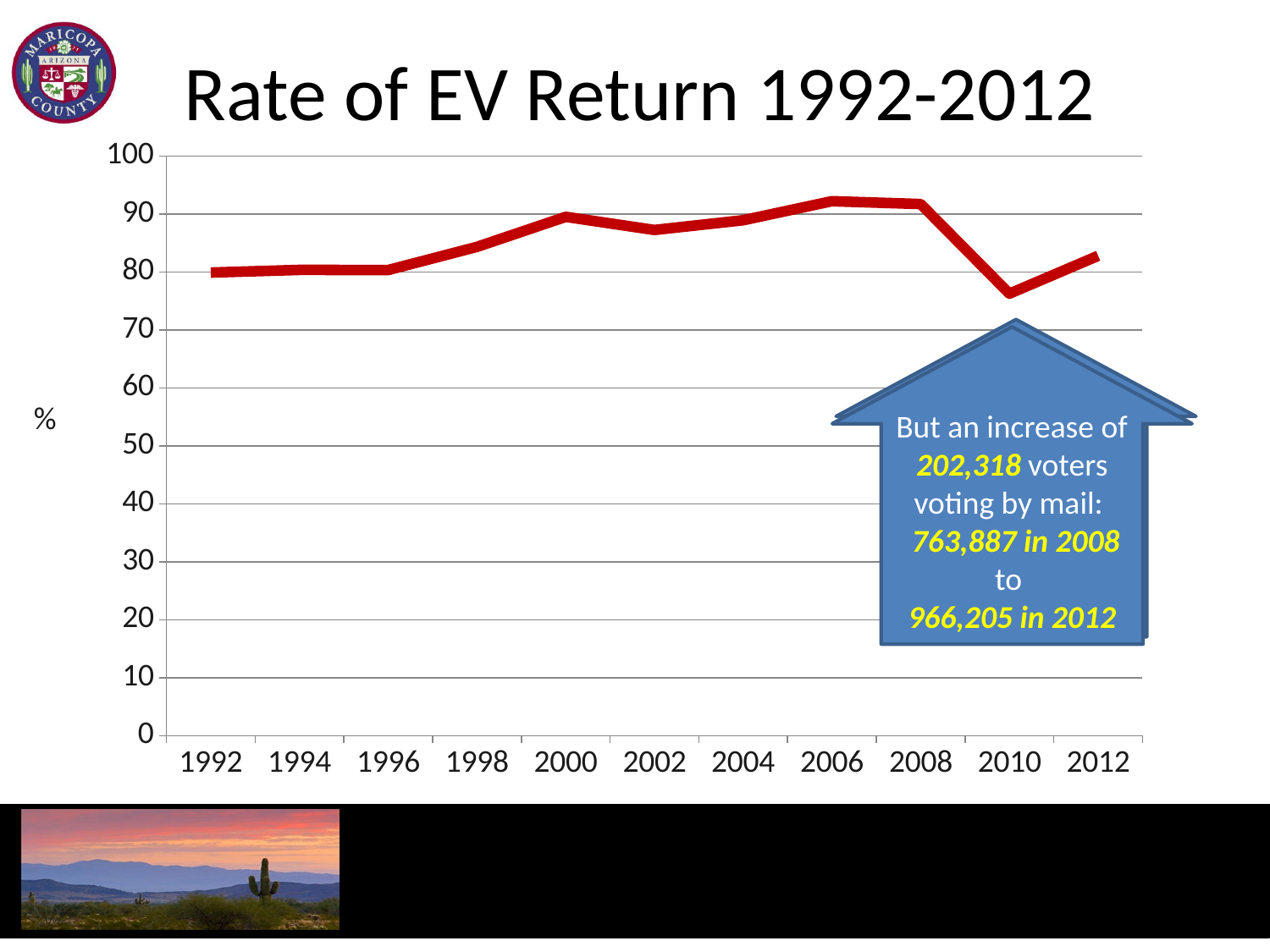
Which year has the higher rate of EV return, 2000 or 2010? 2000 What is the title of the chart? Rate of EV Return 1992-2012 Is the value for 1992 greater or less than 90? less Does the rate of EV return rise or fall between 1996 and 2000? rise Is the value for 2006 greater or less than 90? greater How many years are labelled along the x axis of the chart? 11 Does the rate of EV return rise or fall between 2008 and 2010? fall What label is shown on the y axis of the chart? % What kind of chart is shown on the slide? line chart Is the value for 2010 greater or less than 80? less Which year has the lowest rate of EV return on the chart? 2010